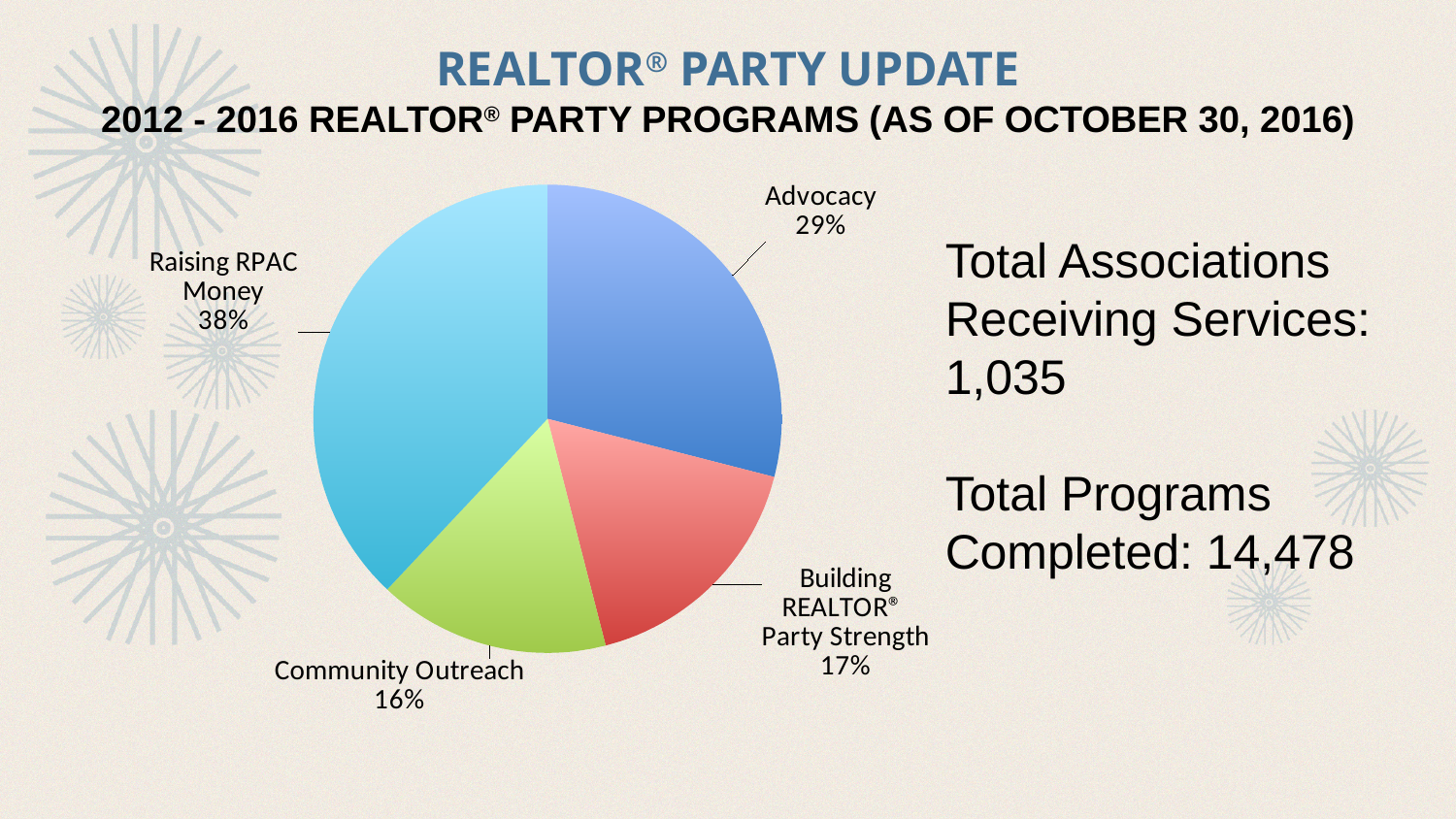
What is the difference in percentage points between Raising RPAC Money and Advocacy? 9 Which is larger, the Advocacy slice or the Community Outreach slice? Advocacy What kind of chart is shown on the slide? Pie chart What share of the pie does Community Outreach represent? 16% What share of the pie does Building REALTOR Party Strength represent? 17% How many categories are shown in the pie chart? 4 Which category has the largest slice of the pie? Raising RPAC Money What is the difference in percentage points between Building REALTOR Party Strength and Community Outreach? 1 What colour is the Community Outreach slice? Green What share of the pie does Advocacy represent? 29% Which category has the smallest slice of the pie? Community Outreach